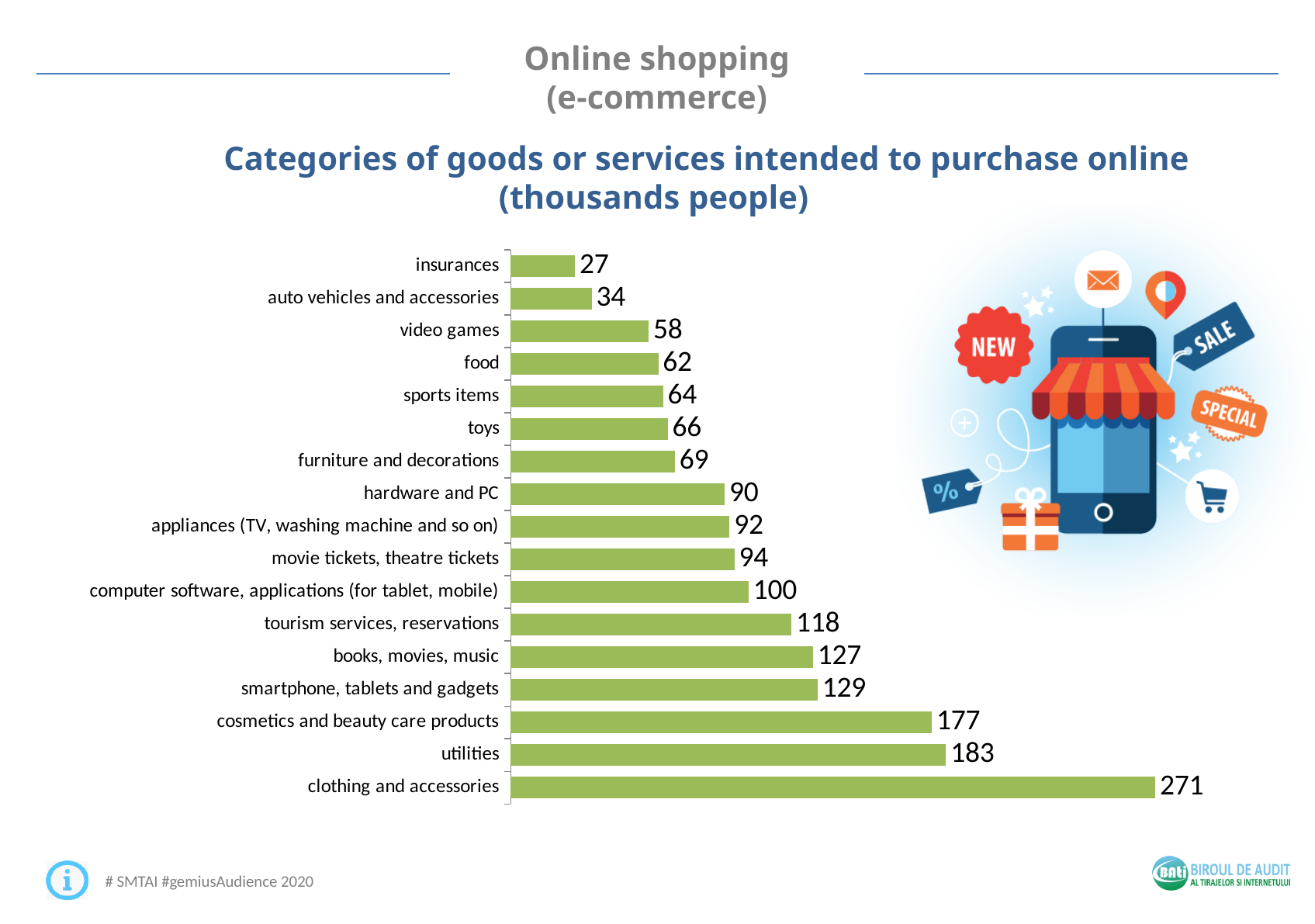
What is the value for tourism services, reservations? 118 What is the value for clothing and accessories? 271 What unit is stated in the chart title for the values? thousands people Which is larger, the value for books, movies, music or the value for smartphone, tablets and gadgets? smartphone, tablets and gadgets What is the difference between the values for clothing and accessories and insurances? 244 What is the difference between the values for utilities and cosmetics and beauty care products? 6 What kind of chart is shown on the slide? bar chart Which category has the lowest value? insurances What is the value for hardware and PC? 90 Which category has the highest value? clothing and accessories How many categories are shown in the chart? 17 Which is larger, the value for food or the value for video games? food